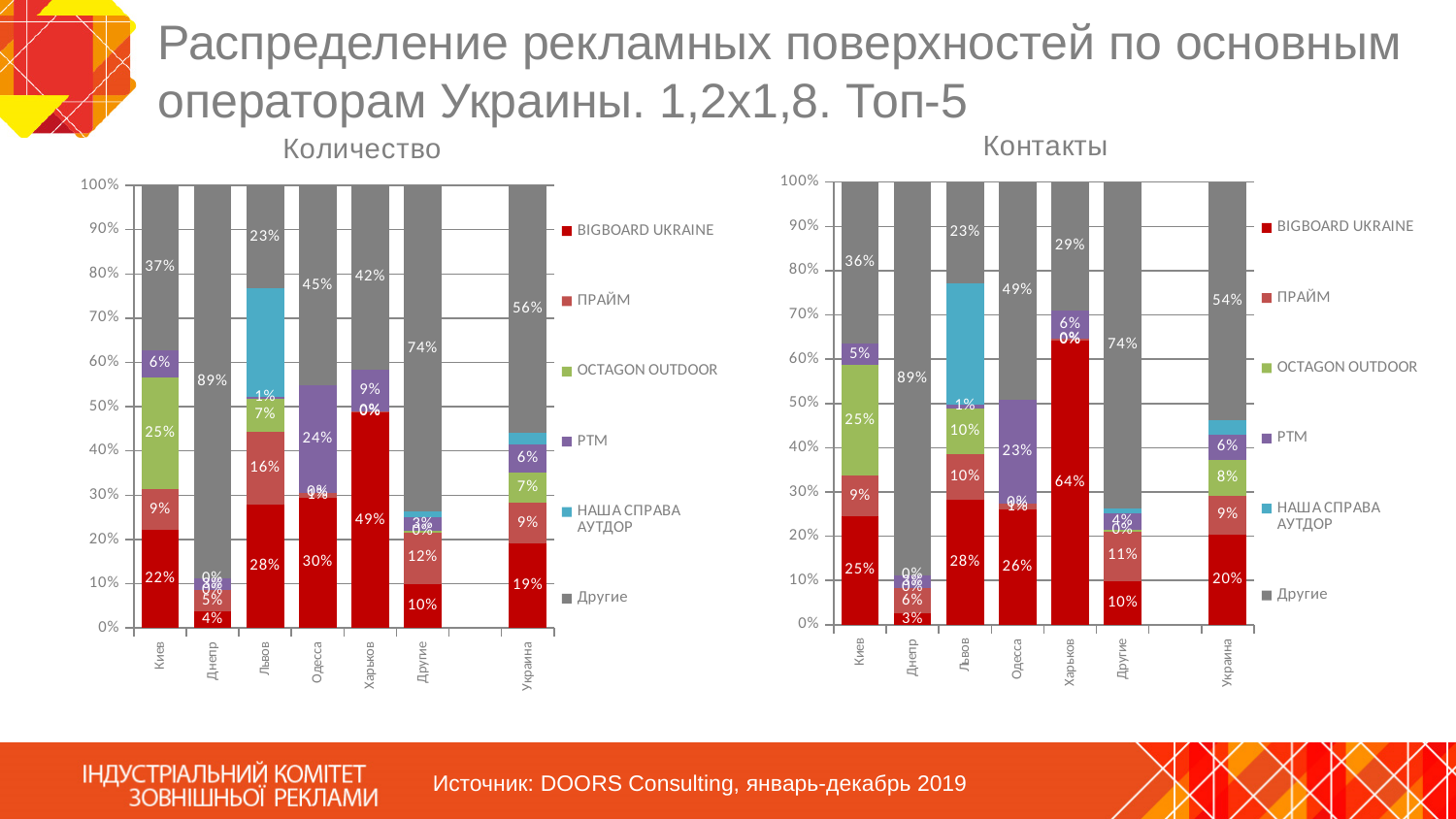
In the "Количество" chart, what is the difference between the Другие share for Украина and for Киев? 19% How many series does the legend of the "Контакты" chart list? 6 How many categories are shown on the x axis of the "Количество" chart? 7 In the "Количество" chart, what is the РТМ share for Одесса? 24% In the "Контакты" chart, which category has the highest Другие share? Днепр In the "Количество" chart, what is the BIGBOARD UKRAINE share for Киев? 22% In the "Контакты" chart, what is the BIGBOARD UKRAINE share for Харьков? 64% In the "Количество" chart, what is the Другие share for Днепр? 89% What kind of chart is the "Количество" chart? stacked bar chart In the "Количество" chart, which category has the highest BIGBOARD UKRAINE share? Харьков In the "Контакты" chart, what is the Другие share for Украина? 54% In the "Контакты" chart, which is larger: the OCTAGON OUTDOOR share for Киев or for Львов? Киев